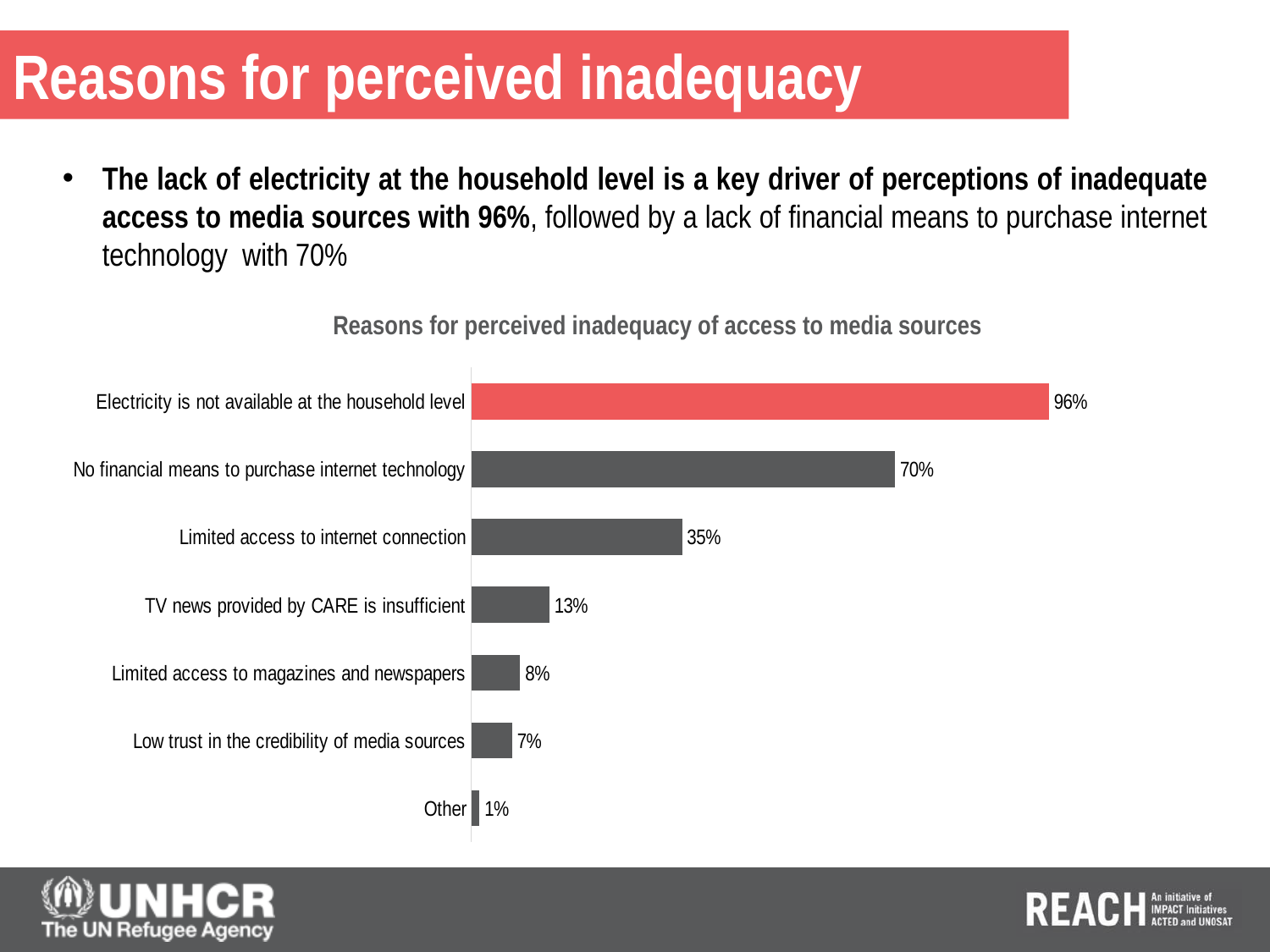
What is the difference between the values for 'Electricity is not available at the household level' and 'No financial means to purchase internet technology'? 26% What is the value for 'Electricity is not available at the household level'? 96% Which category has the highest value? Electricity is not available at the household level What is the difference between the values for 'Limited access to magazines and newspapers' and 'Low trust in the credibility of media sources'? 1% How many categories are shown in the chart? 7 Which is larger: the value for 'Limited access to internet connection' or the value for 'TV news provided by CARE is insufficient'? Limited access to internet connection What is the title of the chart? Reasons for perceived inadequacy of access to media sources What is the value for 'Limited access to internet connection'? 35% What is the value for 'Low trust in the credibility of media sources'? 7% Which category has the lowest value? Other What kind of chart is shown on the slide? Bar chart What is the value for 'TV news provided by CARE is insufficient'? 13%